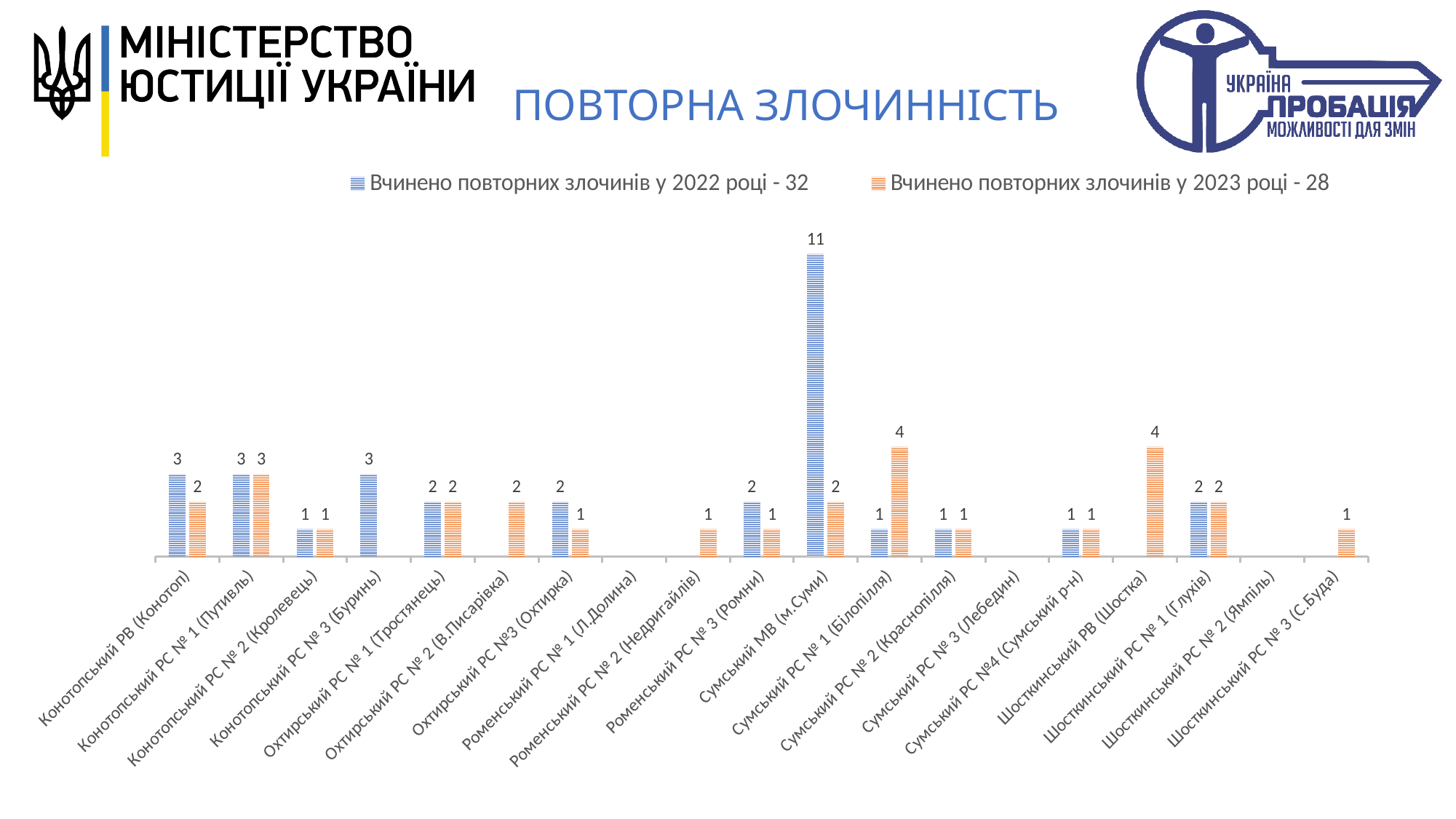
What is the total of the 2022 series according to the legend? 32 What is the value for Конотопський РС № 3 (Буринь) in the 2022 series? 3 How many series does the legend list? 2 What is the value for Сумський МВ (м.Суми) in the 2022 series? 11 What is the difference between the 2022 and 2023 values for Сумський МВ (м.Суми)? 9 What is the title of the chart? ПОВТОРНА ЗЛОЧИННІСТЬ What is the value for Шосткинський РВ (Шостка) in the 2023 series? 4 How many categories are shown on the x axis? 19 What type of chart is shown on the slide? bar chart What is the value for Сумський РС № 1 (Білопілля) in the 2023 series? 4 For Конотопський РВ (Конотоп), which series has the larger value, 2022 or 2023? 2022 Which category has the highest value in the 2022 series? Сумський МВ (м.Суми)